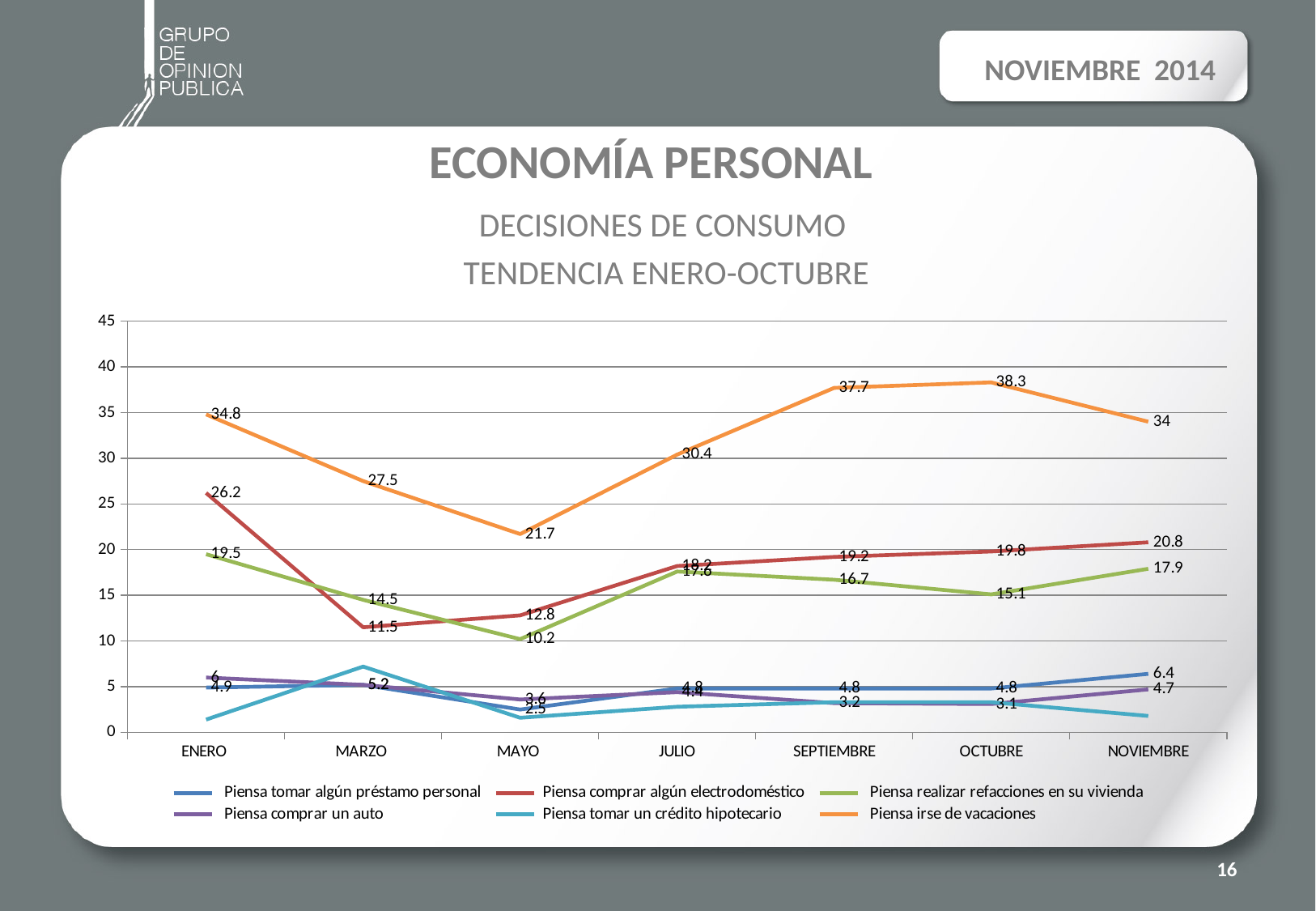
In which month is 'Piensa irse de vacaciones' highest? OCTUBRE How many months are shown on the x axis? 7 In which month is 'Piensa irse de vacaciones' lowest? MAYO What is the difference between the 'Piensa irse de vacaciones' values in OCTUBRE and NOVIEMBRE? 4.3 What is the value for 'Piensa irse de vacaciones' in OCTUBRE? 38.3 What kind of chart is shown on the slide? line chart Is the value for 'Piensa tomar un crédito hipotecario' in MARZO greater or less than 5? greater What is the value for 'Piensa realizar refacciones en su vivienda' in MAYO? 10.2 What is the value for 'Piensa comprar algún electrodoméstico' in ENERO? 26.2 In NOVIEMBRE, which is larger: 'Piensa comprar algún electrodoméstico' or 'Piensa realizar refacciones en su vivienda'? Piensa comprar algún electrodoméstico How many series does the legend list? 6 What is the value for 'Piensa tomar algún préstamo personal' in NOVIEMBRE? 6.4